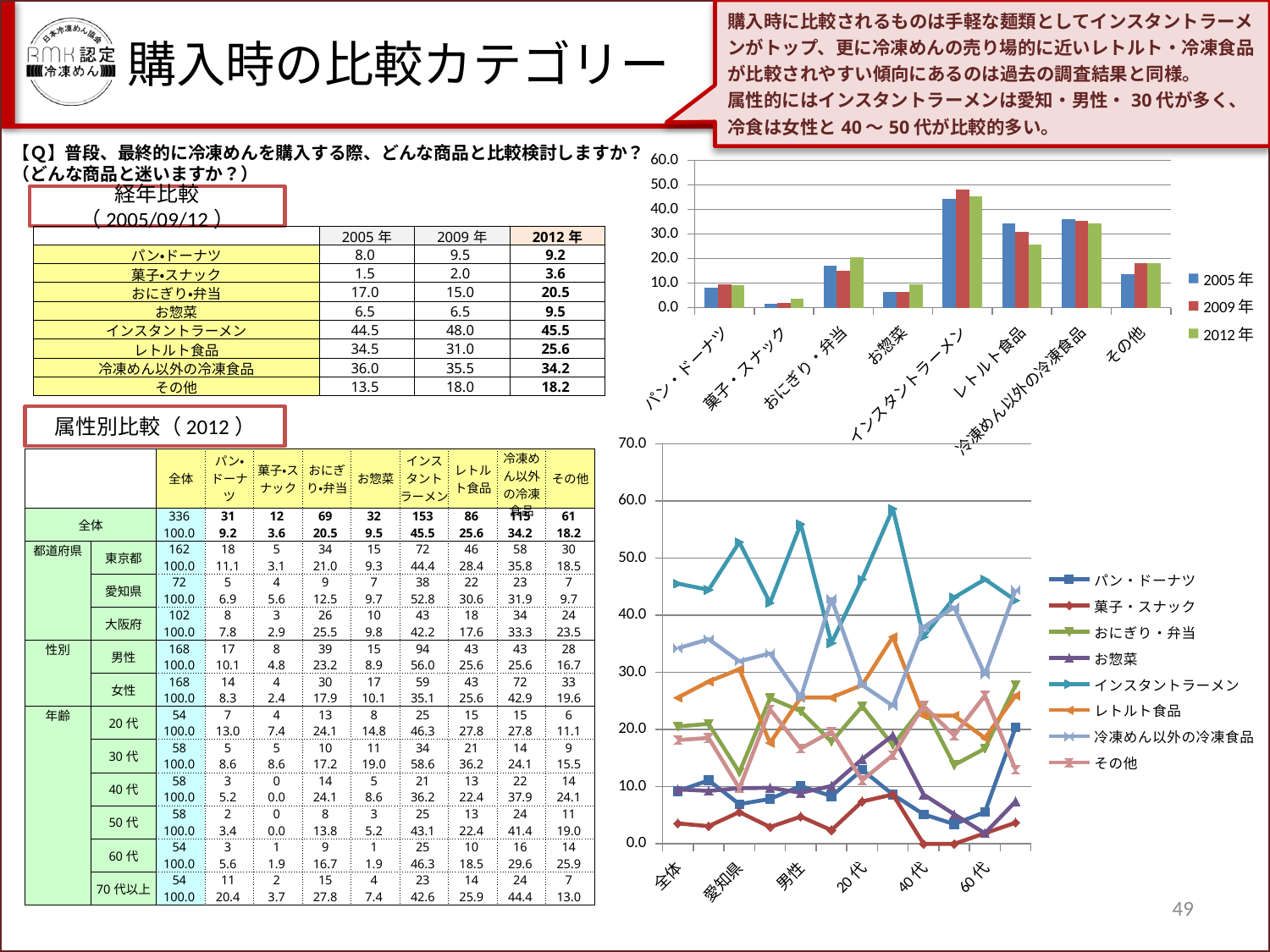
In the top-right bar chart, is the 2012年 value for 冷凍めん以外の冷凍食品 greater or less than 30.0? greater How many series does the legend of the bottom-right line chart list? 8 In the top-right bar chart, which is larger for レトルト食品: the 2005年 value or the 2012年 value? 2005年 What kind of chart is the chart at the top right of the slide? bar chart In the top-right bar chart, what is the 2012年 value for インスタントラーメン? 45.5 In the top-right bar chart, which category has the highest value for 2012年? インスタントラーメン What are the legend entries of the top-right bar chart? 2005年, 2009年, 2012年 What kind of chart is the chart at the bottom right of the slide? line chart How many series does the legend of the top-right bar chart list? 3 In the bottom-right line chart, is the value of インスタントラーメン at 全体 greater or less than 40.0? greater In the top-right bar chart, which category has the lowest value for 2009年? 菓子・スナック How many categories are shown on the x axis of the top-right bar chart? 8